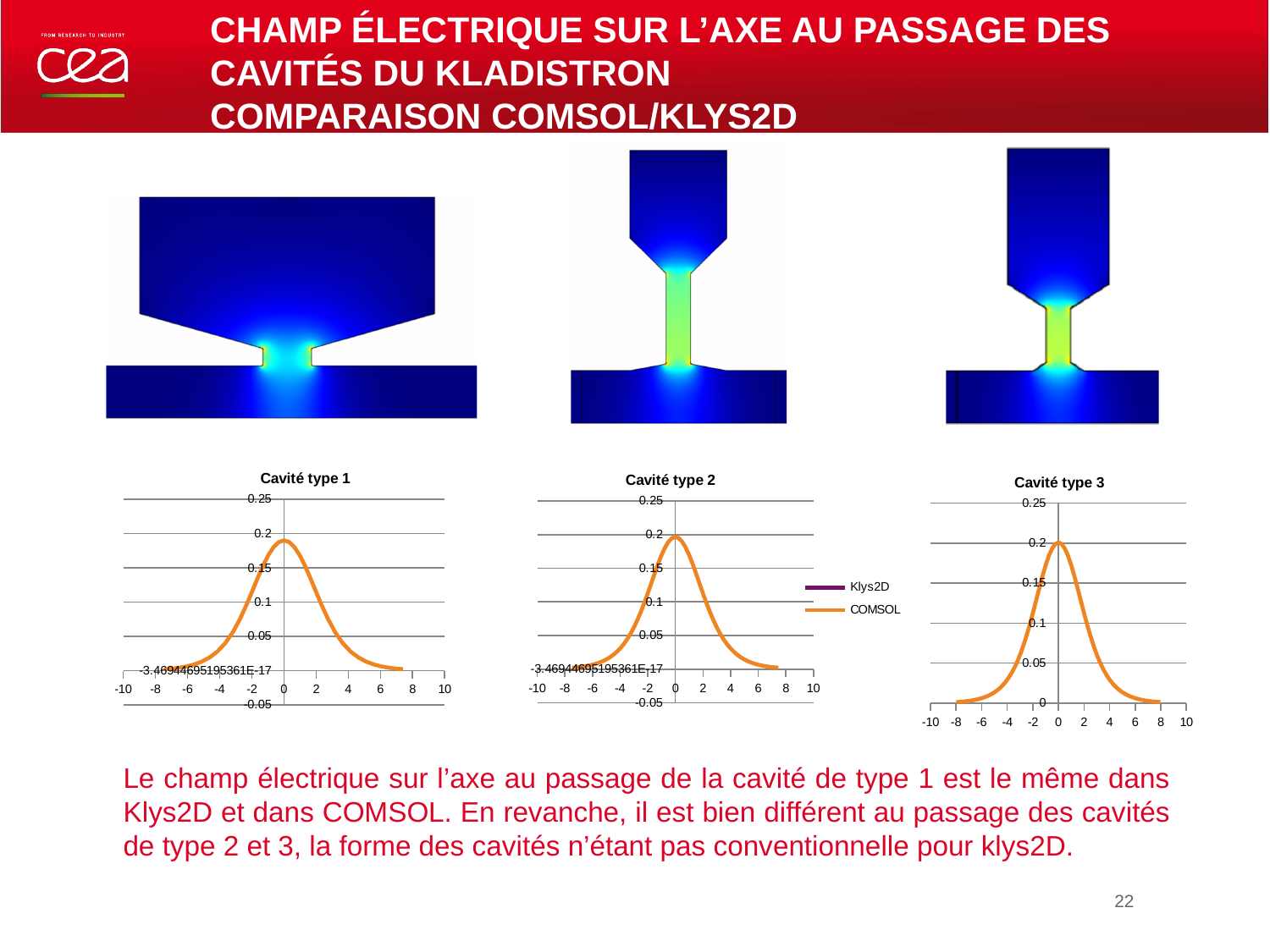
In the "Cavité type 1" chart, is the value at x = -2 greater or less than 0.05? greater How many series does the legend next to the "Cavité type 2" chart list? 2 In the "Cavité type 3" chart, do the values rise or fall as x goes from 0 to 8? fall In the "Cavité type 1" chart, at which x value does the curve reach its maximum? 0 In the "Cavité type 2" chart, do the values rise or fall as x goes from -8 to 0? rise In the "Cavité type 2" chart, is the peak value of the curve greater or less than 0.25? less What are the two series named in the legend next to the "Cavité type 2" chart? Klys2D and COMSOL In the "Cavité type 1" chart, is the value at x = 4 greater or less than 0.1? less What is the highest value shown on the y axis of the "Cavité type 3" chart? 0.25 What is the title of the rightmost chart on the slide? Cavité type 3 What kind of chart is the "Cavité type 1" chart? line chart